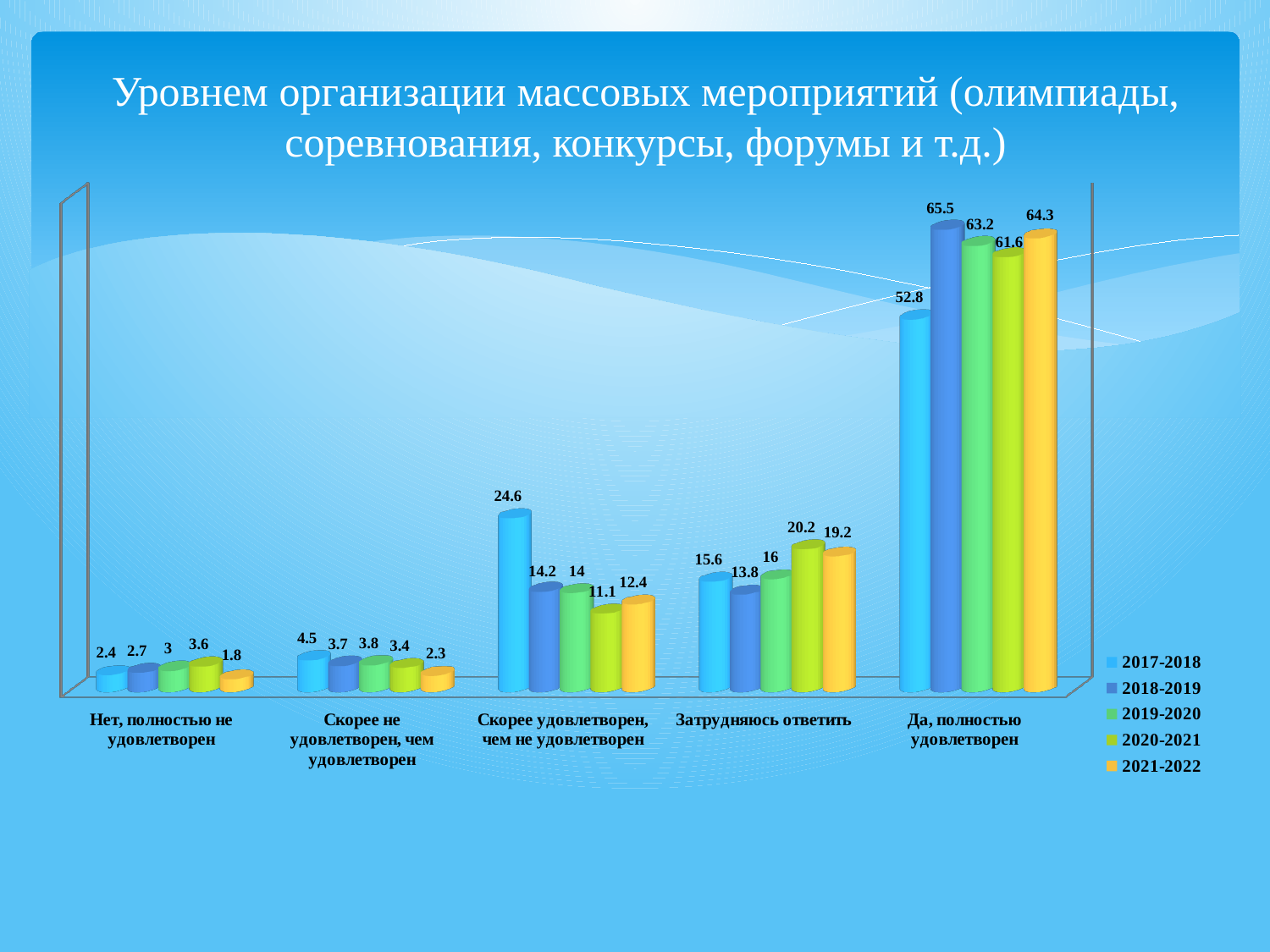
How many categories are shown on the x axis? 5 What is the value for 2017-2018 in the category "Да, полностью удовлетворен"? 52.8 What colour represents the 2021-2022 series in the legend? Yellow Which series has the lowest value in the category "Нет, полностью не удовлетворен"? 2021-2022 What is the difference between the 2017-2018 and 2018-2019 values in the category "Скорее удовлетворен, чем не удовлетворен"? 10.4 Which is larger in the category "Затрудняюсь ответить": the value for 2020-2021 or the value for 2021-2022? 2020-2021 Which category has the highest value for the 2019-2020 series? Да, полностью удовлетворен What kind of chart is shown on the slide? Bar chart What is the value for 2020-2021 in the category "Скорее удовлетворен, чем не удовлетворен"? 11.1 How many series does the legend list? 5 What is the value for 2021-2022 in the category "Затрудняюсь ответить"? 19.2 Which series has the highest value in the category "Да, полностью удовлетворен"? 2018-2019